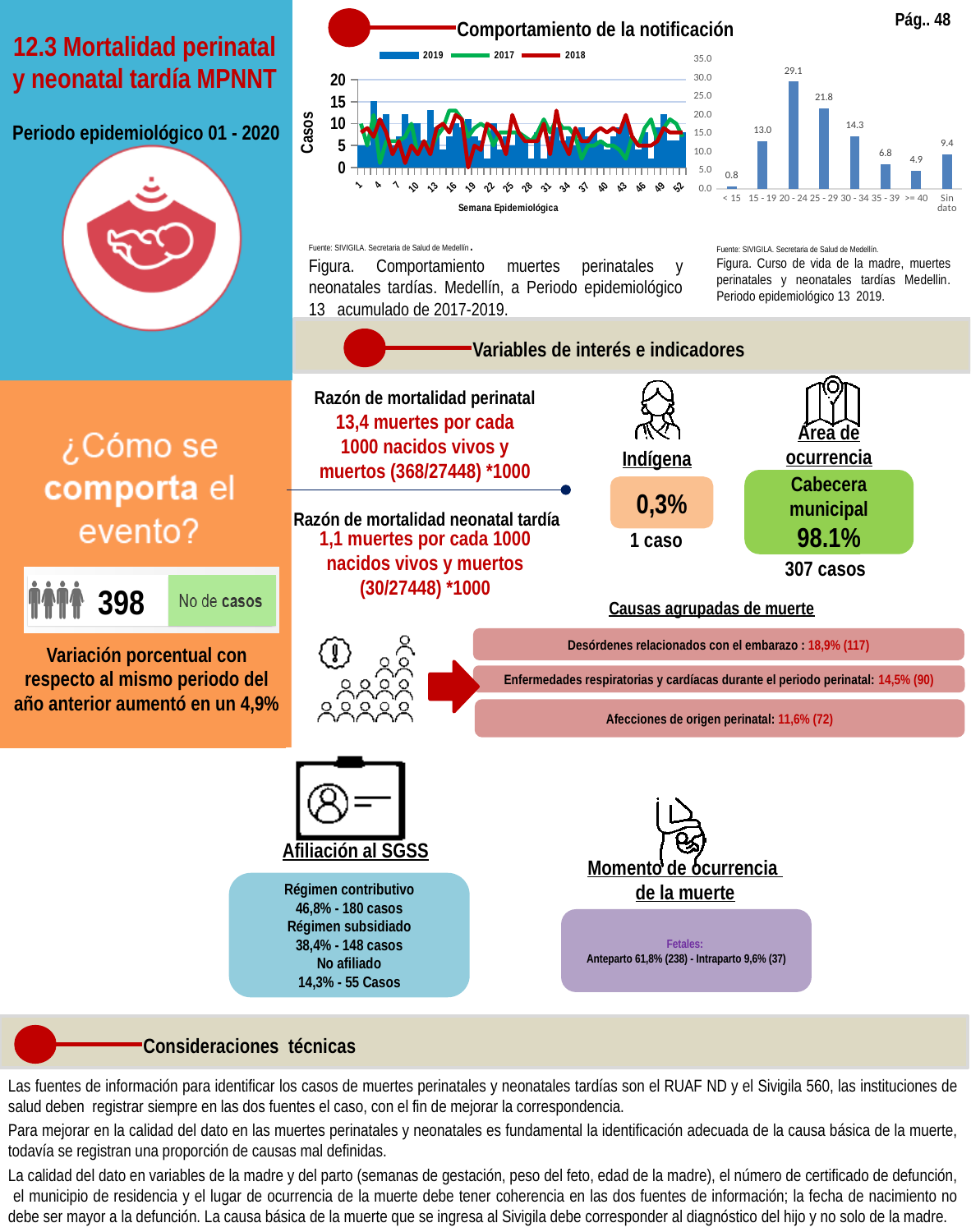
In the bar chart on the right (age groups of the mother), what is the difference between the 20 - 24 and 25 - 29 values? 7.3 In the bar chart on the right (age groups of the mother), what is the value for the 20 - 24 group? 29.1 In the bar chart on the right (age groups of the mother), which is larger: the value for 15 - 19 or for 30 - 34? 30 - 34 In the bar chart on the right (age groups of the mother), is the value for 35 - 39 greater or less than 10.0? less What kind of chart is the chart on the right showing the age groups of the mother? bar chart How many series does the legend of the 'Comportamiento de la notificación' chart list? 3 In the bar chart on the right (age groups of the mother), which category has the lowest value? < 15 In the bar chart on the right (age groups of the mother), what is the value for the 'Sin dato' category? 9.4 In the bar chart on the right (age groups of the mother), what is the value for the < 15 group? 0.8 In the bar chart on the right (age groups of the mother), which age group has the highest value? 20 - 24 How many categories are shown in the bar chart on the right (age groups of the mother)? 8 In the 'Comportamiento de la notificación' chart, which years are listed in the legend? 2019, 2017, 2018